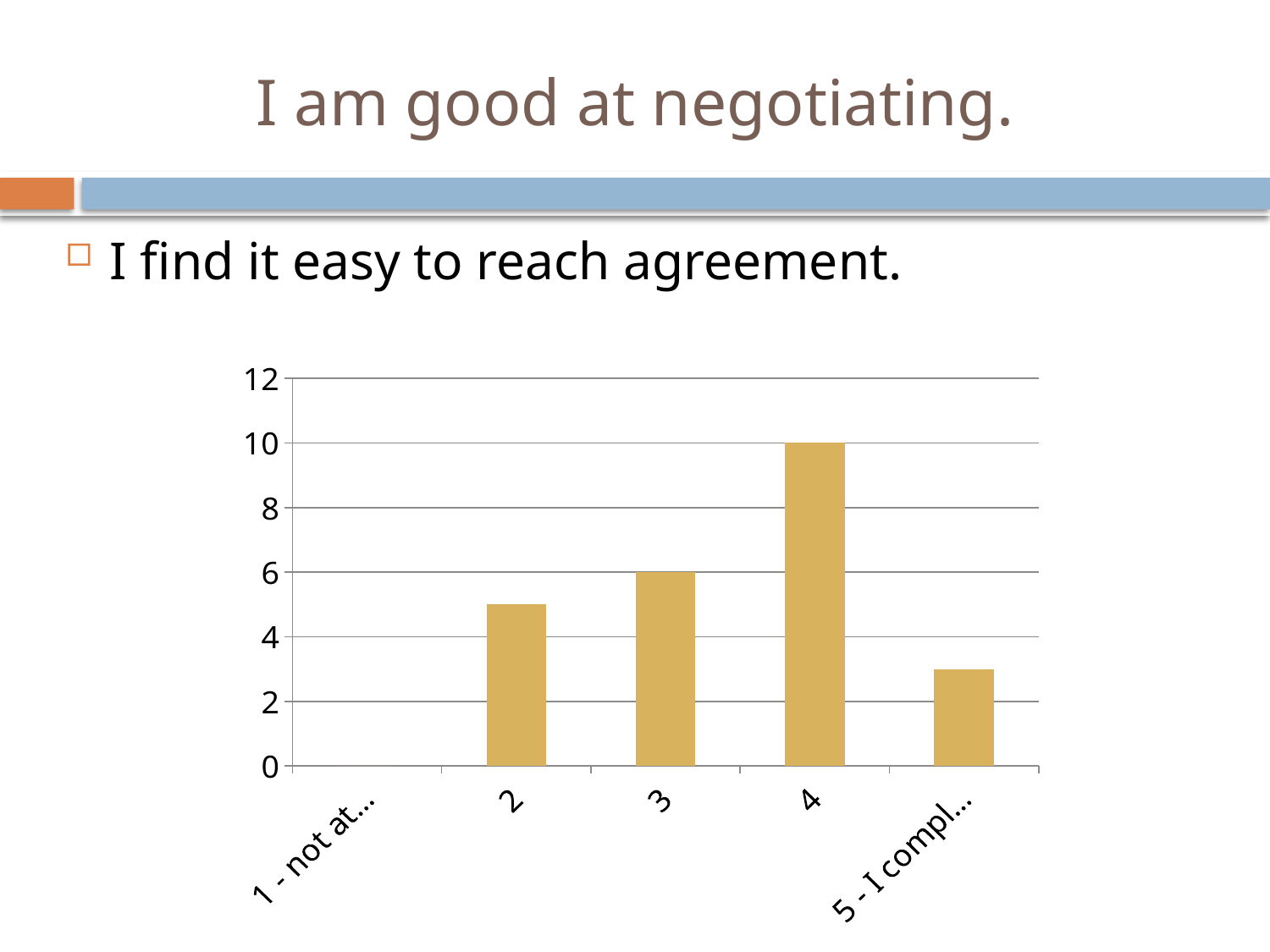
Which category has the lowest value? 1 - not at... Is the value for category 2 greater or less than 4? greater Which category has the highest value? 4 What kind of chart is shown on the slide? bar chart Which is larger, the value for category 4 or the value for category 3? 4 What is the value for category 3? 6 Is the value for the category labelled '5 - I compl...' greater or less than 4? less What is the value for category 4? 10 What is the difference between the value for category 4 and the value for category 3? 4 Do the values rise or fall from category 2 to category 4? rise How many categories are shown on the x axis? 5 Is the value for category 2 greater or less than 6? less